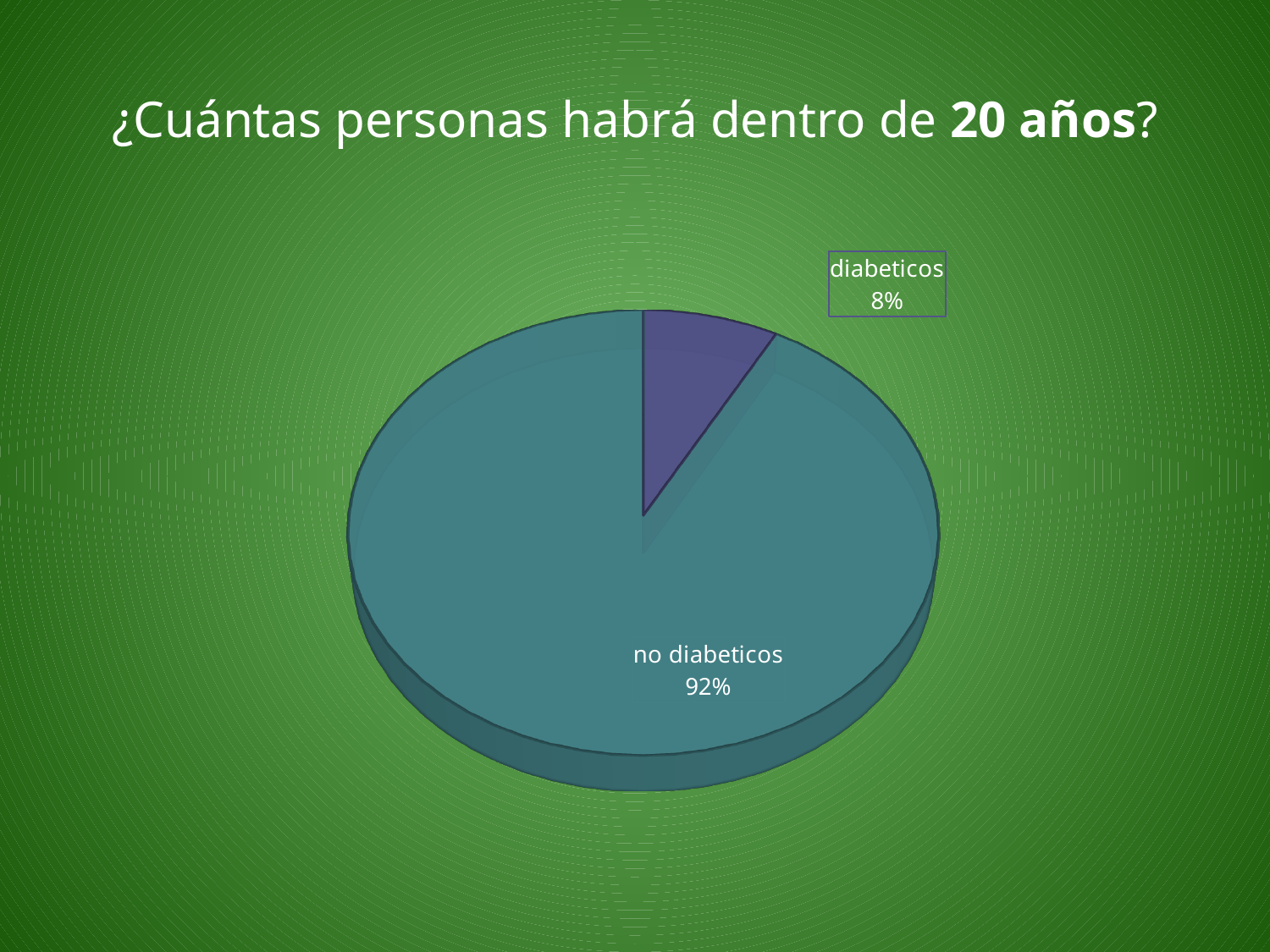
Which slice of the pie is the largest? no diabeticos What percentage of the pie is labelled "diabeticos"? 8% What kind of chart is shown on the slide? pie chart What is the total of the two slice percentages shown? 100% How many slices does the pie chart have? 2 What colour is the "diabeticos" slice? purple Which slice is larger, "diabeticos" or "no diabeticos"? no diabeticos What percentage of the pie is labelled "no diabeticos"? 92% What share of the pie does the "diabeticos" slice represent? 8% What is the title text shown above the chart? ¿Cuántas personas habrá dentro de 20 años? Which slice of the pie is the smallest? diabeticos What is the difference in percentage points between the "no diabeticos" and "diabeticos" slices? 84